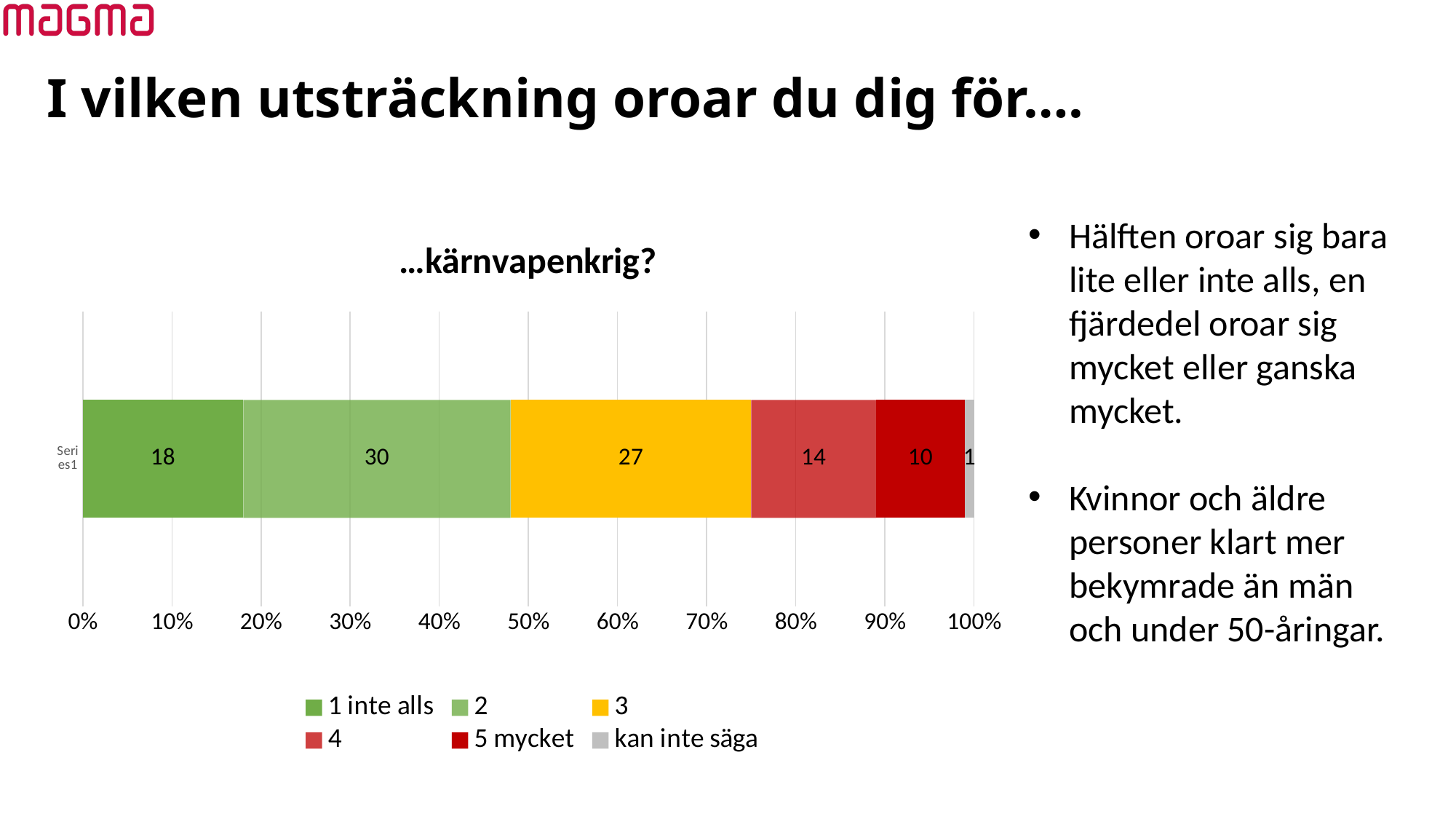
Which series has the smallest value in the stacked bar? kan inte säga What is the difference between the values for "3" and "4"? 13 How many series does the legend list? 6 What kind of chart is shown on the slide? Stacked bar chart What is the total of all segments in the stacked bar? 100 Which series has the largest value in the stacked bar? 2 What is the value for the "5 mycket" series? 10 What is the value for the "1 inte alls" series? 18 Which is larger, the value for "1 inte alls" or the value for "4"? 1 inte alls What is the title of the chart? …kärnvapenkrig? What is the value for the "2" series in the chart? 30 What colour is the "3" series in the chart? Yellow